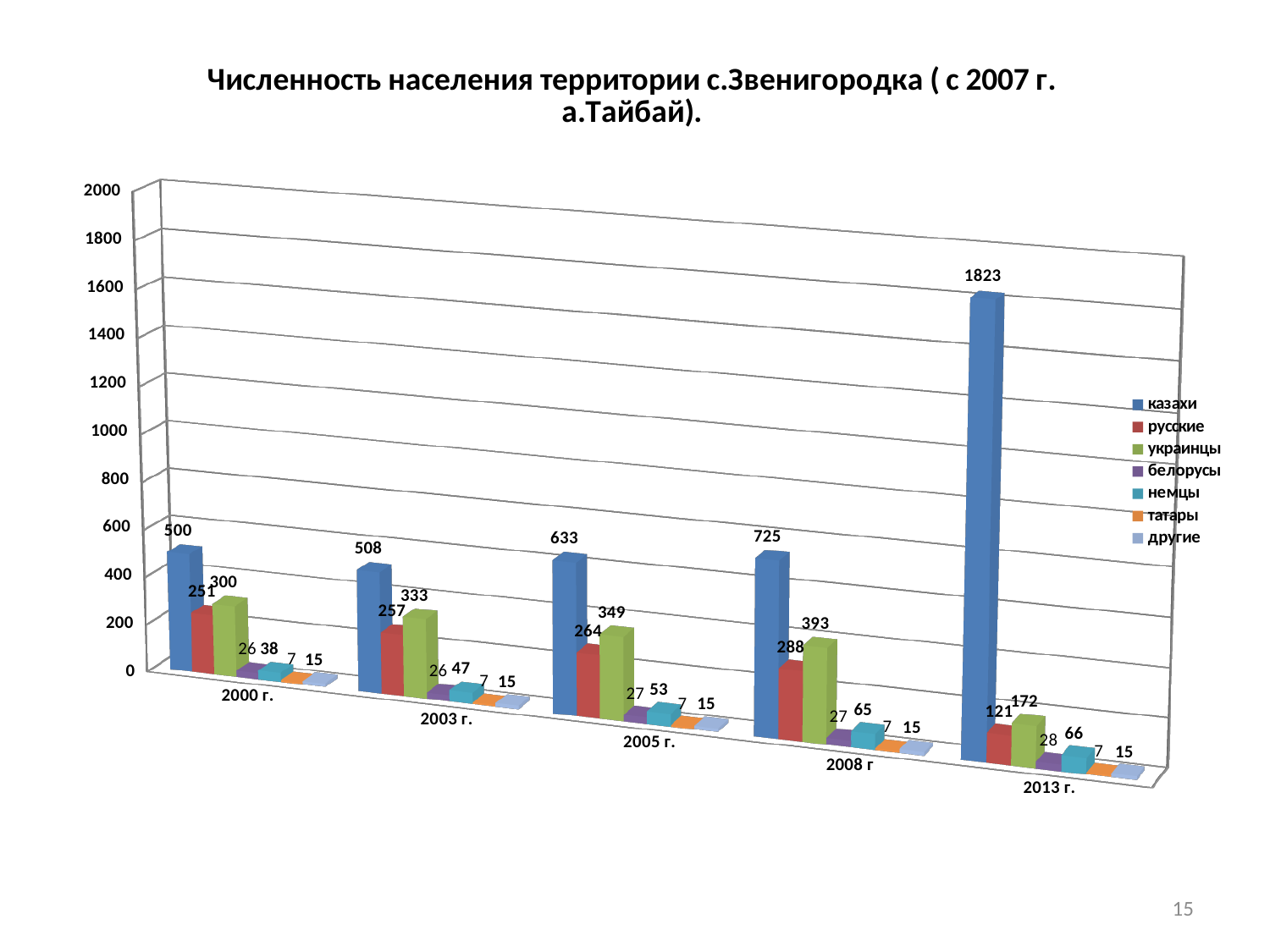
Do the values for казахи rise or fall from 2000 г. to 2013 г.? rise What is the value for русские in 2000 г.? 251 In which year is the value for казахи the highest? 2013 г. Which is larger in 2003 г.: the value for русские or the value for украинцы? украинцы How many series does the legend list? 7 What kind of chart is shown on the slide? bar chart What is the value for немцы in 2005 г.? 53 How many year categories are shown on the x axis? 5 What is the value for украинцы in 2008 г? 393 What is the value for казахи in 2013 г.? 1823 In which year is the value for русские the lowest? 2013 г. What is the difference between the казахи values in 2013 г. and 2008 г? 1098